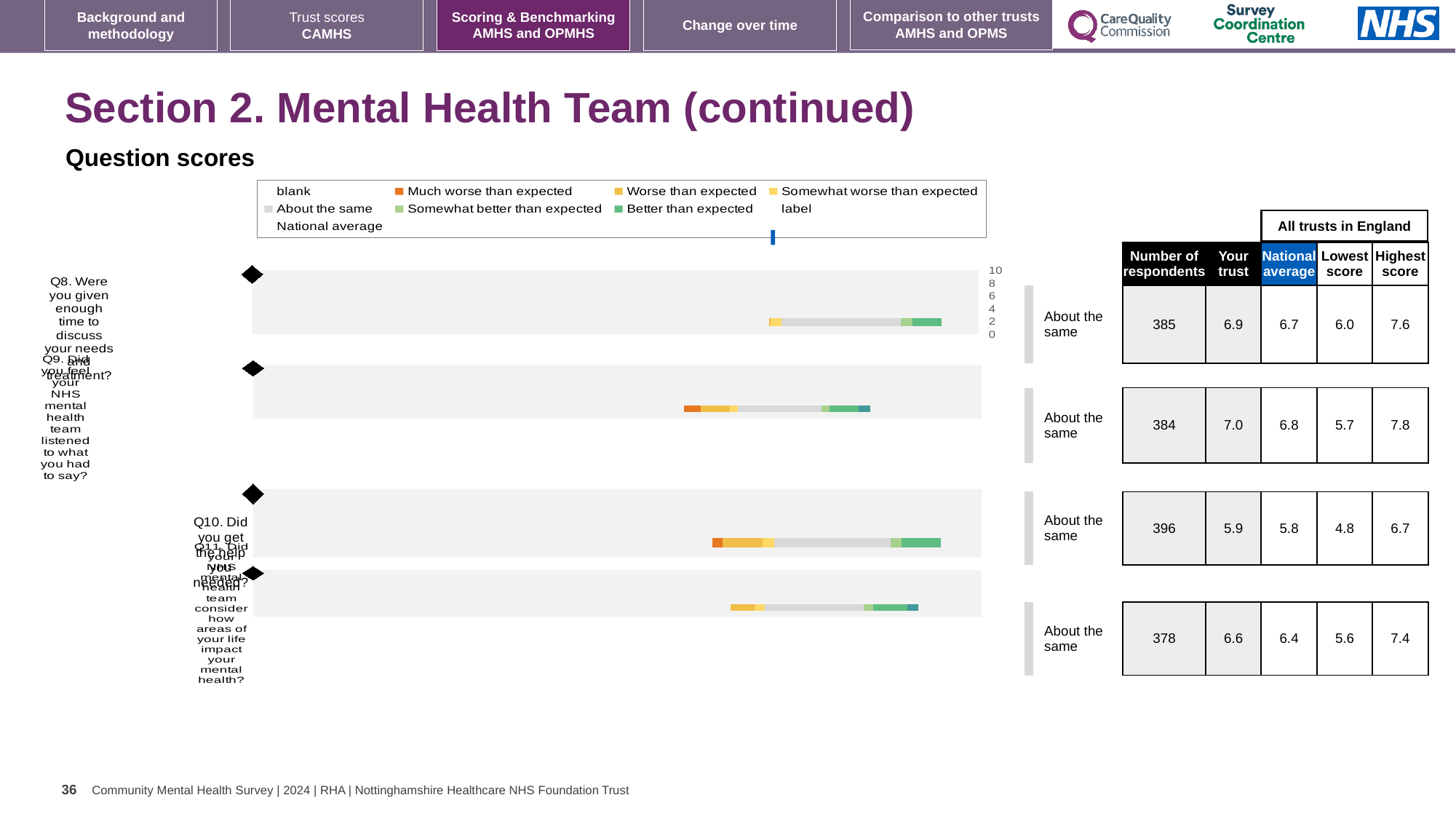
What kind of chart is used to show the question scores on this slide? bar chart How many questions (categories) are plotted in the question scores chart? 4 In the table beside the chart, what is the 'Your trust' score for Q8 (Were you given enough time to discuss your needs and treatment?)? 6.9 In the table beside the chart, how many respondents answered Q10 (Did you get the help you needed?)? 396 Which legend entry in the question scores chart is shown in light grey? About the same In the table beside the chart, what is the national average for Q9 (Did you feel your NHS mental health team listened to what you had to say?)? 6.8 According to the table beside the chart, which question has the highest 'Your trust' score? Q9 According to the table beside the chart, which question has the lowest 'Your trust' score? Q10 In the table beside the chart, is the 'Your trust' score for Q11 higher or lower than the national average for Q11? higher In the table beside the chart, what is the highest score across all trusts in England for Q11? 7.4 In the table beside the chart, what is the difference between the 'Your trust' score and the national average for Q8? 0.2 Which legend entry in the question scores chart is shown in orange? Much worse than expected